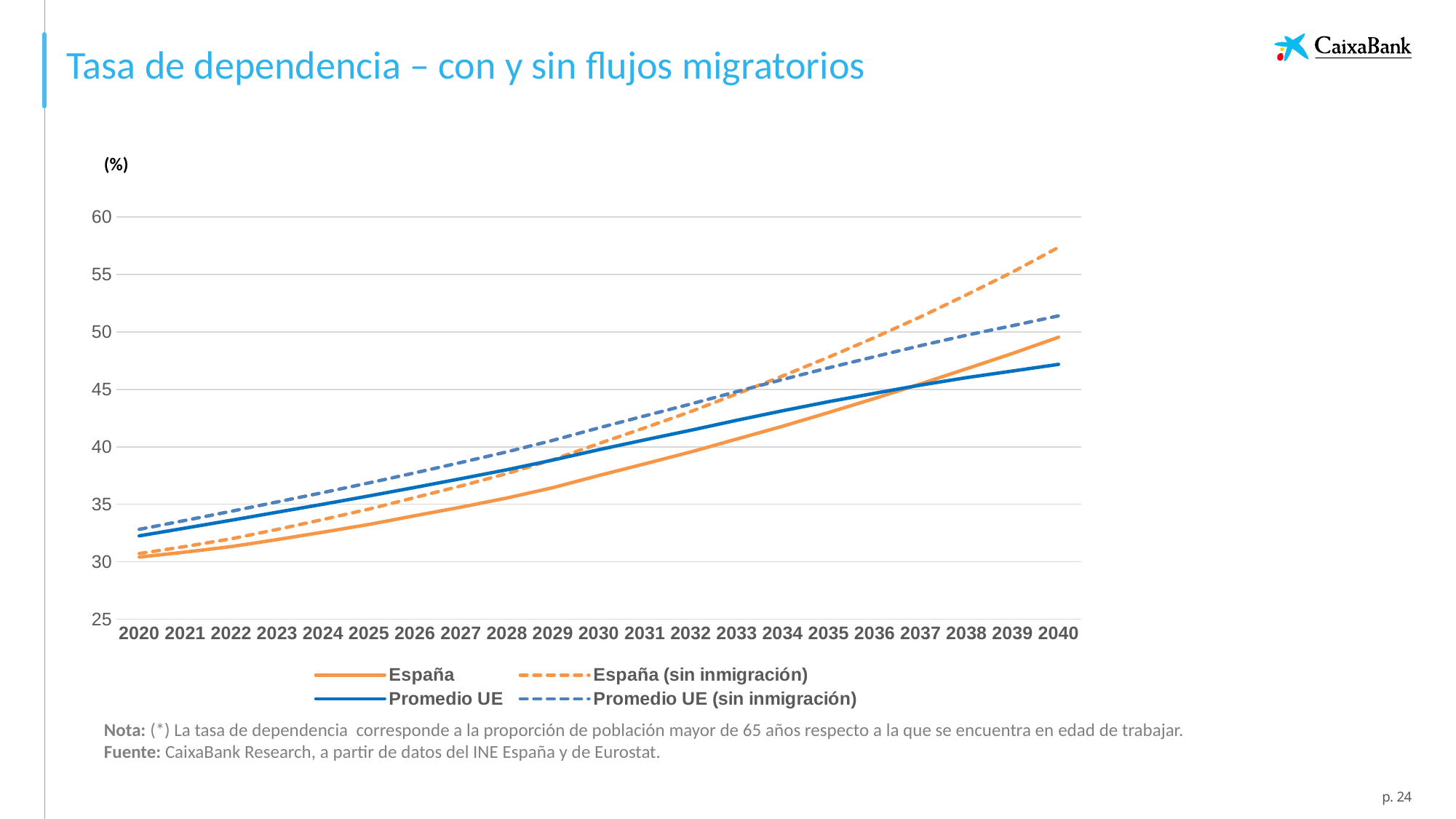
How many series does the legend list? 4 In 2040, which is higher: España (sin inmigración) or Promedio UE (sin inmigración)? España (sin inmigración) Which series has the highest value in 2040? España (sin inmigración) Is the value for Promedio UE in 2040 greater or less than 50? less Does the España series rise or fall from 2020 to 2040? rise Which series has the lowest value in 2040? Promedio UE How many years are shown on the x axis? 21 Is the value for Promedio UE (sin inmigración) in 2040 greater or less than 45? greater What kind of chart is shown on the slide? line chart Is the value for España (sin inmigración) in 2040 greater or less than 55? greater In 2030, which is higher: Promedio UE or España? Promedio UE